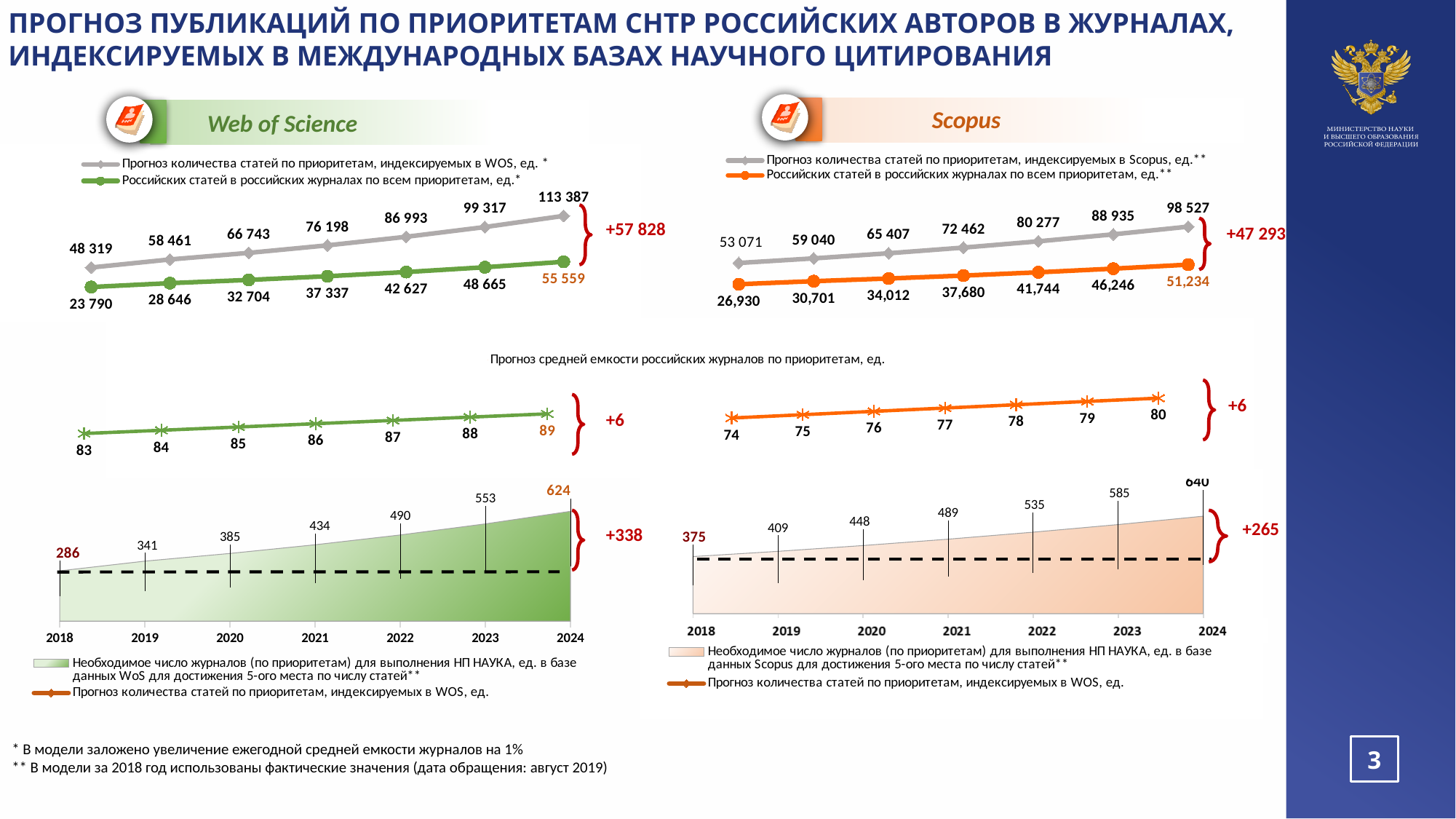
In the Web of Science top line chart, what is the first (leftmost) value of the green line for Russian articles in Russian journals? 23 790 In the Scopus area chart at the bottom right, what is the value for 2018? 375 In the Scopus average journal capacity chart (middle right), what is the first (leftmost) value? 74 In the Web of Science top line chart, what is the last (rightmost) value of the grey forecast line for articles indexed in WOS? 113 387 In the Scopus top line chart, what is the first (leftmost) value of the grey forecast line for articles indexed in Scopus? 53 071 In the Web of Science area chart at the bottom left, how many years are shown on the x axis? 7 In the Web of Science average journal capacity chart (middle left), do the values rise or fall from left to right? rise In the Web of Science area chart at the bottom left, what is the value for 2024? 624 In the Web of Science area chart at the bottom left, what is the difference between the 2024 and 2018 values? 338 In the Scopus top line chart, what is the last (rightmost) value of the orange line for Russian articles in Russian journals? 51,234